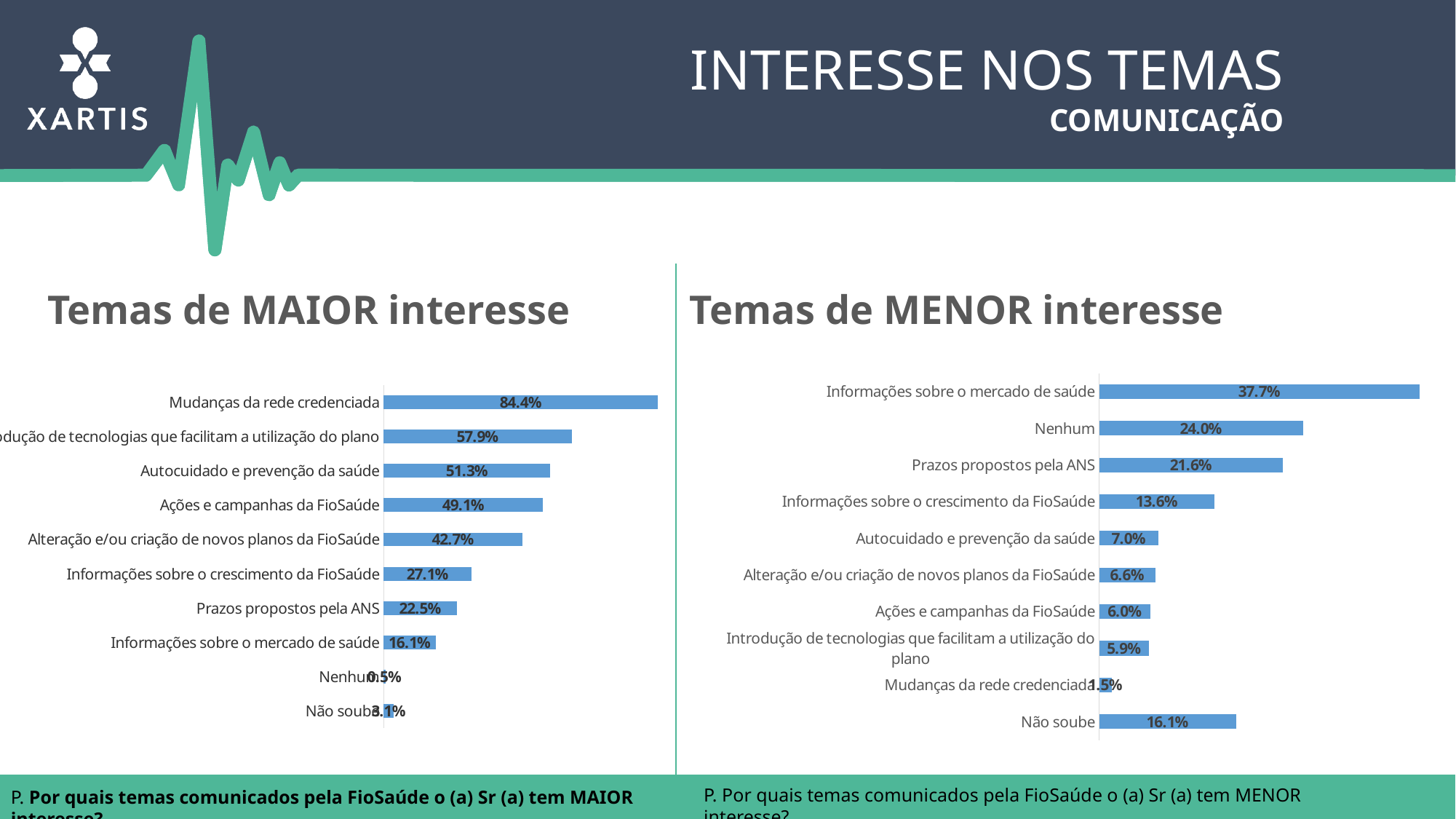
In the 'Temas de MAIOR interesse' chart, which category has the highest value? Mudanças da rede credenciada In the 'Temas de MENOR interesse' chart, which is larger: 'Prazos propostos pela ANS' or 'Não soube'? Prazos propostos pela ANS In the 'Temas de MENOR interesse' chart, what is the difference between 'Informações sobre o mercado de saúde' and 'Nenhum'? 13.7 percentage points In the 'Temas de MENOR interesse' chart, which category has the highest value? Informações sobre o mercado de saúde In the 'Temas de MAIOR interesse' chart, what is the difference between 'Mudanças da rede credenciada' and 'Alteração e/ou criação de novos planos da FioSaúde'? 41.7 percentage points In the 'Temas de MENOR interesse' chart, what is the value for 'Nenhum'? 24.0% What type of chart is the 'Temas de MAIOR interesse' chart? Bar chart In the 'Temas de MAIOR interesse' chart, what is the value for 'Prazos propostos pela ANS'? 22.5% In the 'Temas de MENOR interesse' chart, what is the value for 'Informações sobre o crescimento da FioSaúde'? 13.6% In the 'Temas de MAIOR interesse' chart, what is the value for 'Mudanças da rede credenciada'? 84.4% In the 'Temas de MAIOR interesse' chart, what is the value for 'Autocuidado e prevenção da saúde'? 51.3% How many categories are shown in the 'Temas de MENOR interesse' chart? 10